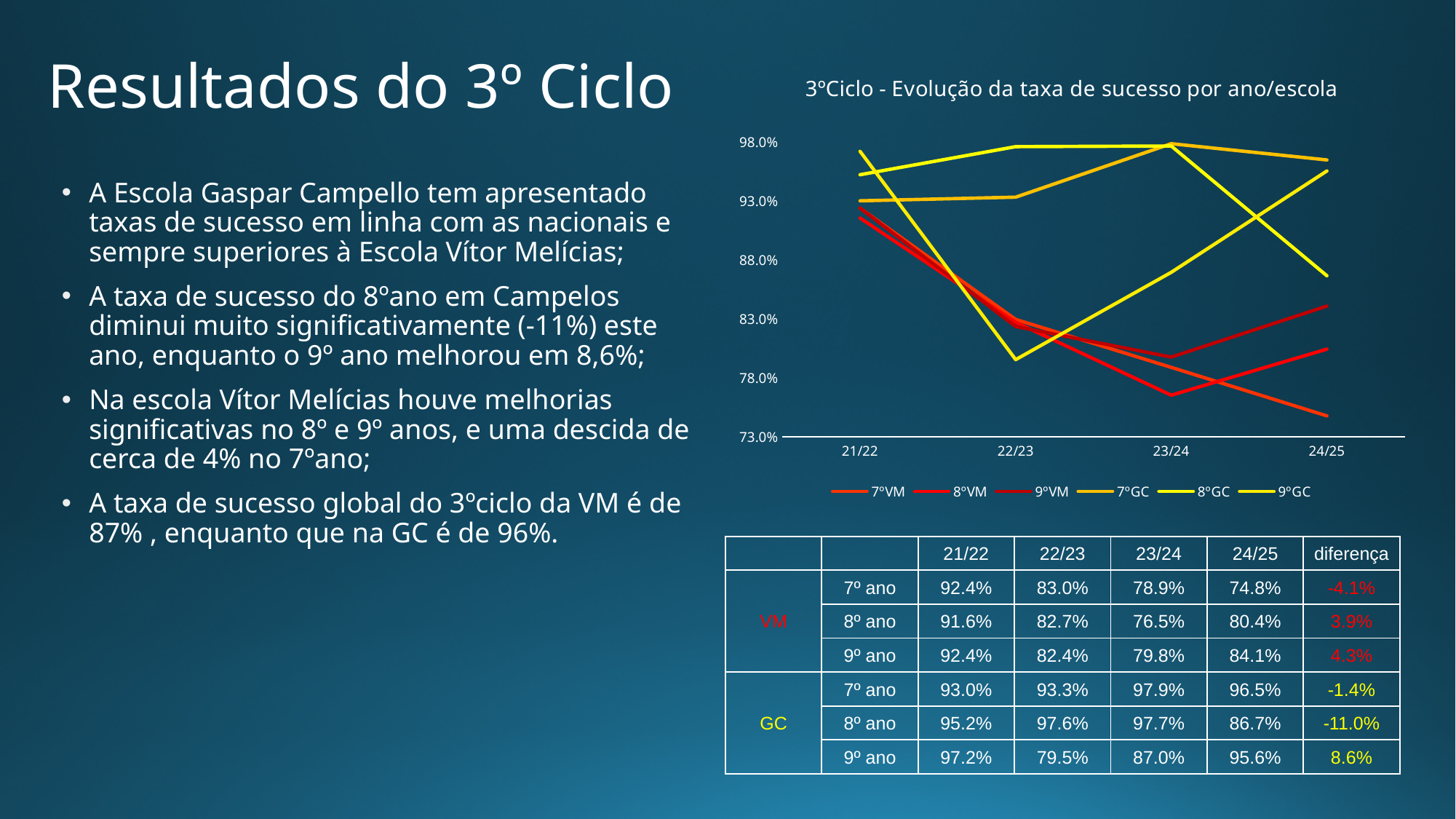
What is the success rate for 8ºGC in 24/25? 86.7% Is the value for 8ºVM in 23/24 greater or less than 78.0%? less What is the success rate for 9ºVM in 21/22? 92.4% In 21/22, which is higher: 9ºGC or 7ºVM? 9ºGC Is the value for 7ºGC in 23/24 greater or less than 93.0%? greater How many school years are plotted along the x axis of the chart? 4 Which series has the lowest value in 24/25? 7ºVM Does the 7ºVM series rise or fall from 21/22 to 24/25? fall What kind of chart is shown on the slide? line chart Is the value for 9ºGC in 22/23 greater or less than 83.0%? less What is the title of the chart? 3ºCiclo - Evolução da taxa de sucesso por ano/escola How many series does the chart legend list? 6